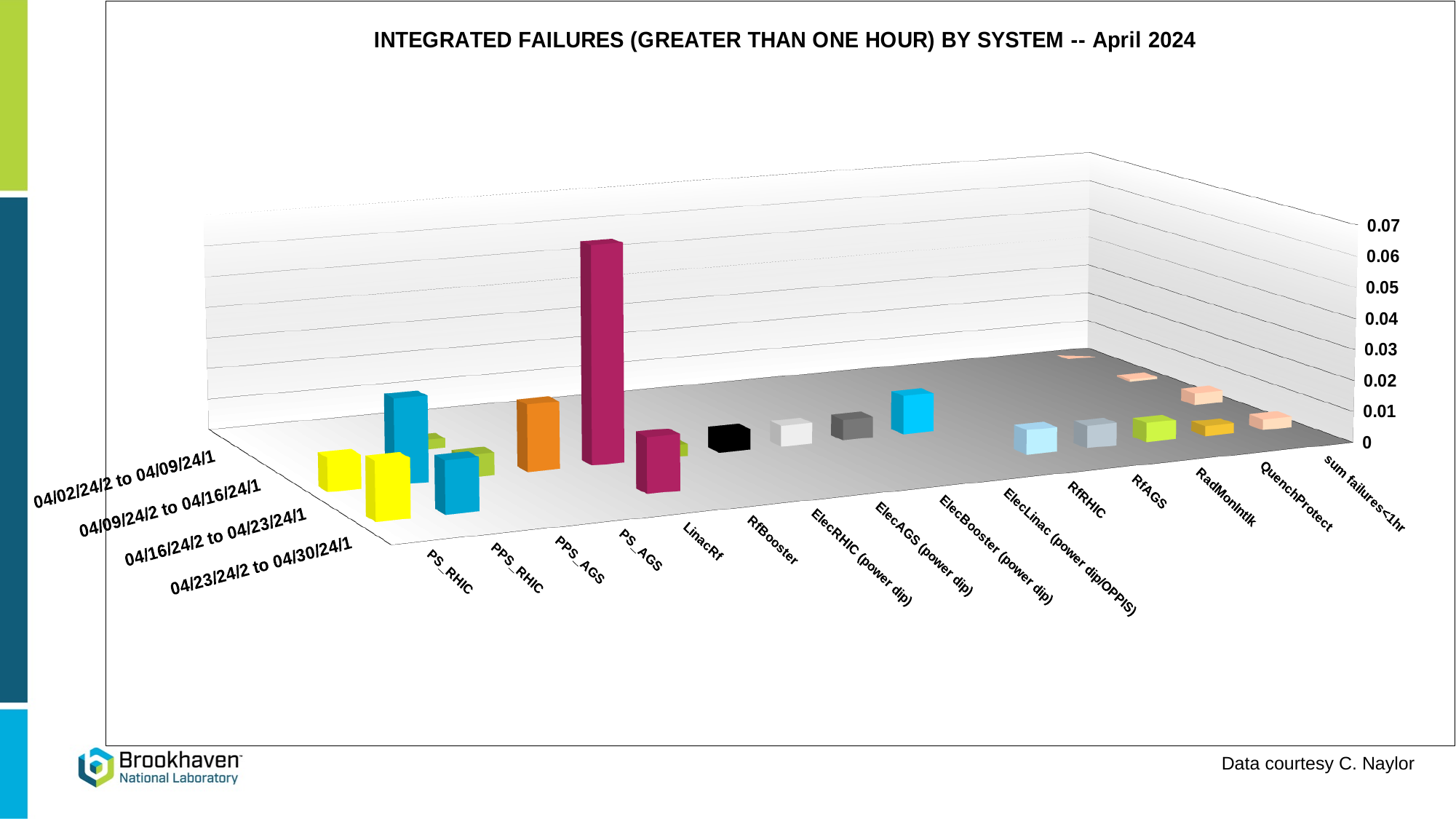
What is the label of the last system on the horizontal axis? sum failures<1hr How many systems are listed along the horizontal axis of the chart? 15 Are the bars for PS_RHIC greater or less than 0.03? less What is the label of the first weekly period on the depth axis? 04/02/24/2 to 04/09/24/1 What is the highest value shown on the vertical axis of the chart? 0.07 Which is larger, the tallest bar for PS_AGS or the tallest bar for PPS_AGS? PS_AGS How many weekly periods are listed along the depth axis of the chart? 4 What kind of chart is shown on the slide? 3D bar chart What is the title of the chart? INTEGRATED FAILURES (GREATER THAN ONE HOUR) BY SYSTEM -- April 2024 Which system has the tallest bar in the chart? LinacRf